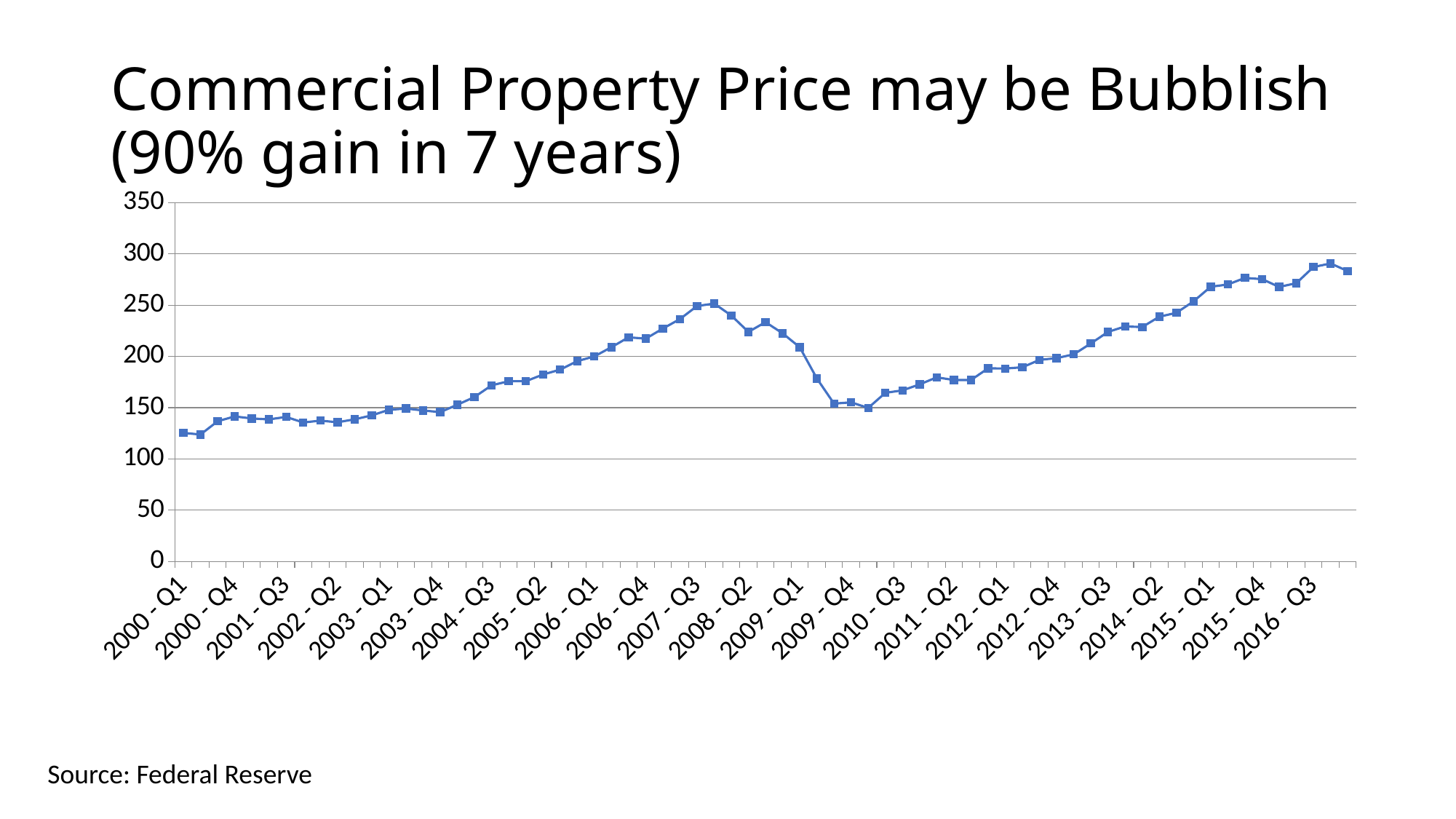
What is the title of the chart on the slide? Commercial Property Price may be Bubblish (90% gain in 7 years) Is the value for 2008 - Q2 greater or less than 200? greater Is the value for 2016 - Q3 greater or less than 250? greater Which is larger, the value for 2007 - Q3 or the value for 2016 - Q3? 2016 - Q3 What kind of chart is shown on the slide? line chart Is the value for 2012 - Q1 greater or less than 200? less Overall, do the values rise or fall from 2000 - Q1 to 2016 - Q3? rise Which is larger, the value for 2008 - Q2 or the value for 2009 - Q4? 2008 - Q2 What source is cited for the chart? Federal Reserve